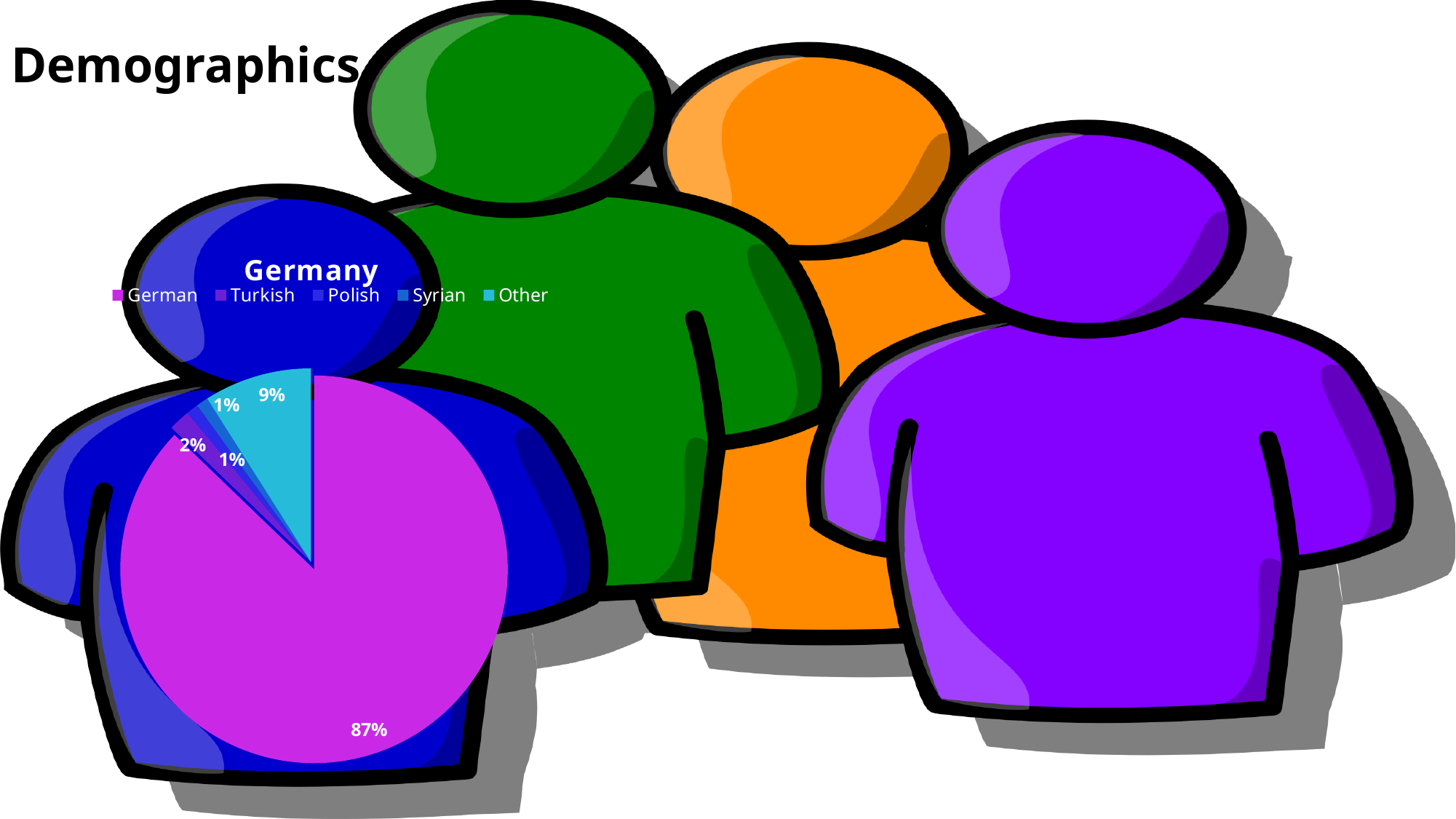
What percentage of the pie is labelled Polish? 1% What percentage of the pie is labelled German? 87% Which category has the largest slice of the pie? German What share of the pie does the German slice represent? 87% What is the title of the pie chart? Germany What kind of chart is shown on the slide? pie chart What percentage of the pie is labelled Turkish? 2% What is the difference in percentage points between the German slice and the Other slice? 78 What percentage of the pie is labelled Syrian? 1% How many categories does the legend of the pie chart list? 5 Which slice is larger, Other or Turkish? Other What percentage of the pie is labelled Other? 9%